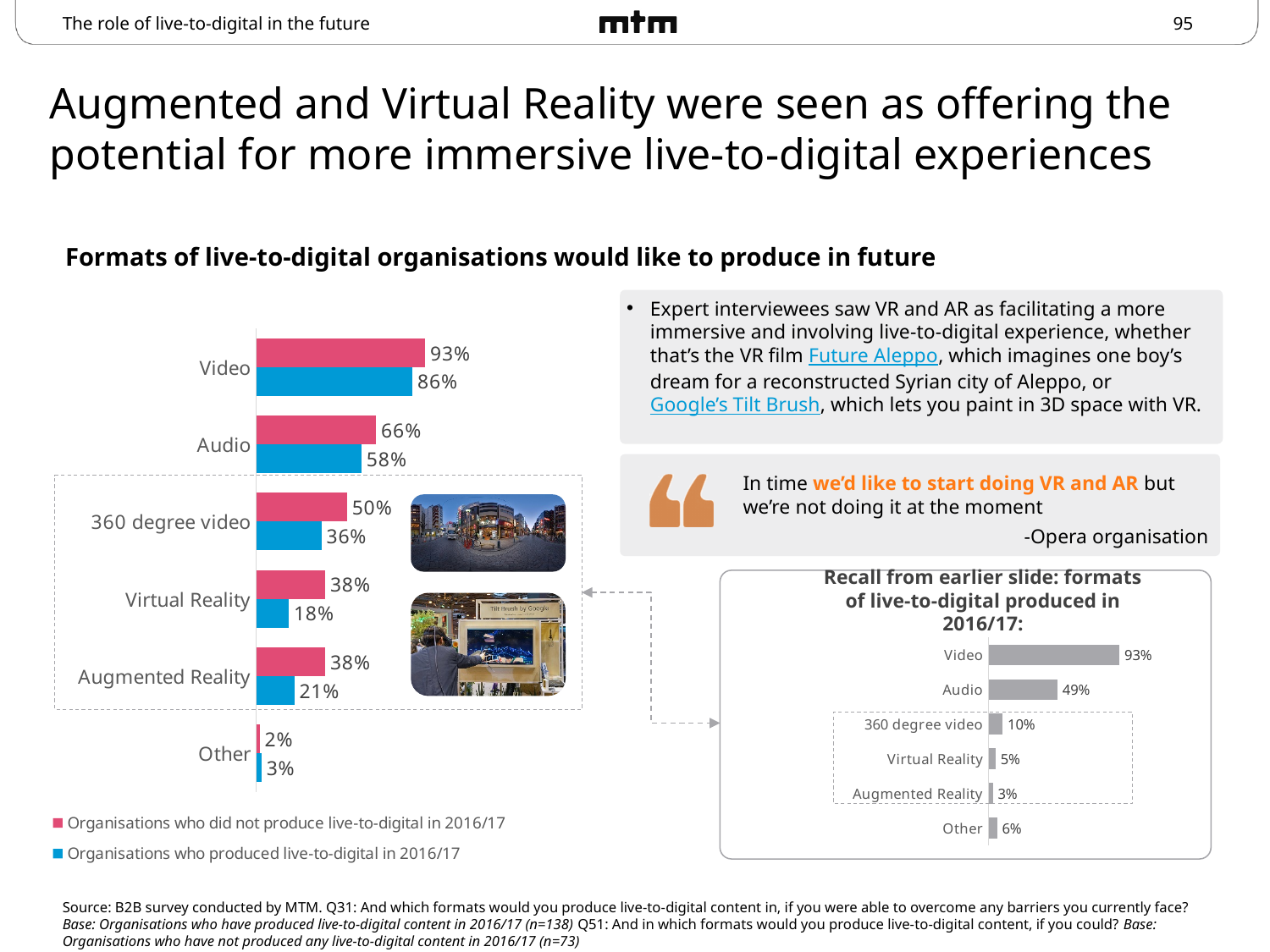
How many series does the legend of the chart 'Formats of live-to-digital organisations would like to produce in future' list? 2 In the chart 'Formats of live-to-digital organisations would like to produce in future', what is the value for Virtual Reality among organisations who produced live-to-digital in 2016/17? 18% In the chart 'Formats of live-to-digital organisations would like to produce in future', which category has the lowest value for organisations who did not produce live-to-digital in 2016/17? Other In the chart 'Formats of live-to-digital organisations would like to produce in future', what is the value for Video among organisations who did not produce live-to-digital in 2016/17? 93% In the chart 'Formats of live-to-digital organisations would like to produce in future', what is the difference between the two series' values for 360 degree video? 14 percentage points In the chart 'Formats of live-to-digital organisations would like to produce in future', which series has the larger value for Augmented Reality? Organisations who did not produce live-to-digital in 2016/17 In the chart 'Formats of live-to-digital organisations would like to produce in future', which category has the highest value for organisations who produced live-to-digital in 2016/17? Video What type of chart is 'Formats of live-to-digital organisations would like to produce in future'? Bar chart In the chart 'Recall from earlier slide: formats of live-to-digital produced in 2016/17', what is the value for Audio? 49% In the chart 'Formats of live-to-digital organisations would like to produce in future', what colour are the bars for organisations who produced live-to-digital in 2016/17? Blue How many categories are shown in the chart 'Formats of live-to-digital organisations would like to produce in future'? 6 In the chart 'Recall from earlier slide: formats of live-to-digital produced in 2016/17', which category has the lowest value? Augmented Reality